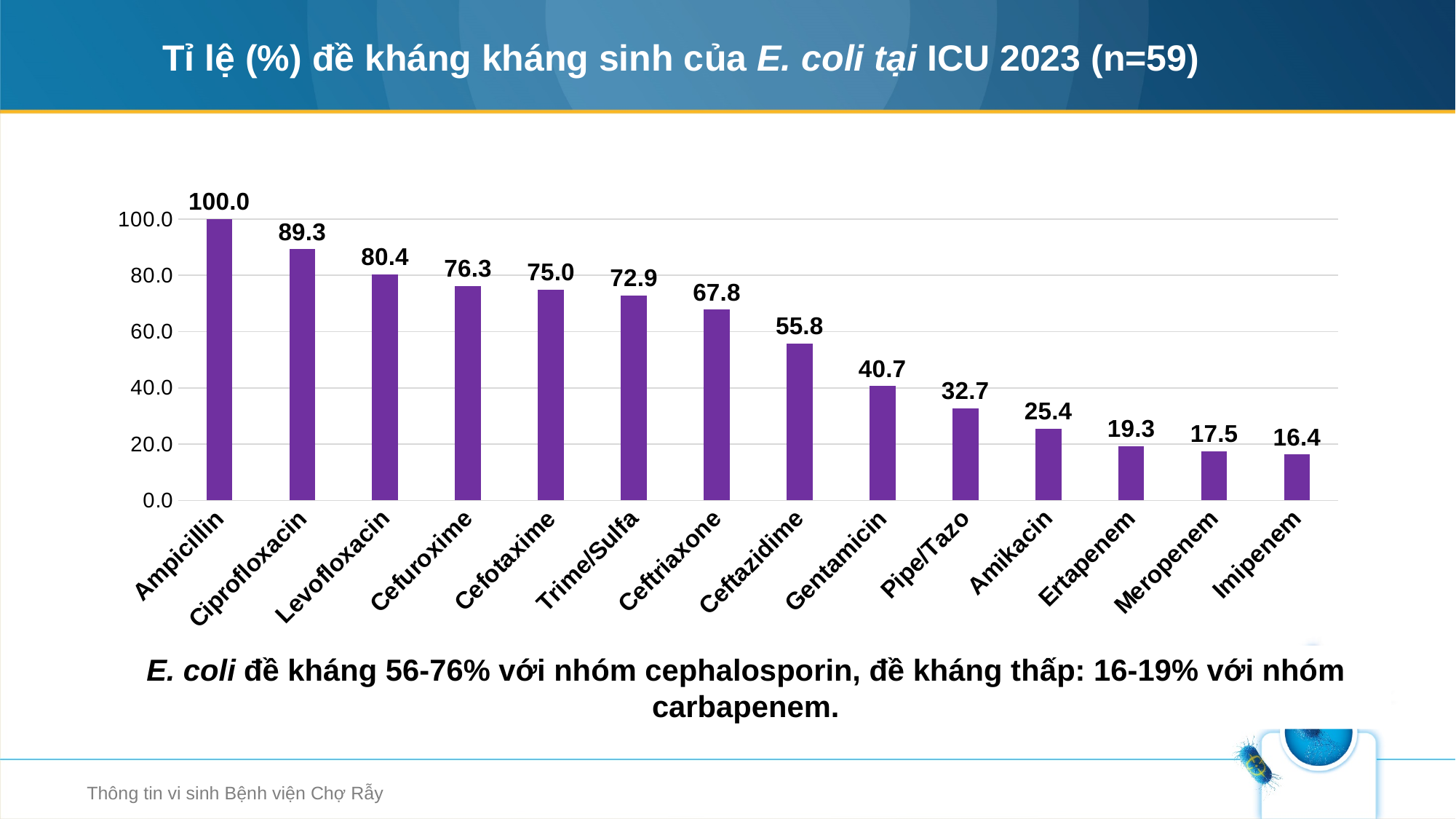
What is the resistance rate for Ciprofloxacin? 89.3 What is the value shown for Meropenem? 17.5 What kind of chart is shown on the slide? bar chart Is the value for Pipe/Tazo greater or less than 40.0? less Which antibiotic has the lowest resistance rate? Imipenem What is the difference between the values for Ertapenem and Imipenem? 2.9 Do the values rise or fall from left to right along the x axis? fall Which antibiotic has the highest resistance rate? Ampicillin What is the value shown for Ceftazidime? 55.8 How many antibiotics are shown on the x axis? 14 What is the difference between the values for Levofloxacin and Gentamicin? 39.7 Which has a higher value, Cefotaxime or Ceftriaxone? Cefotaxime